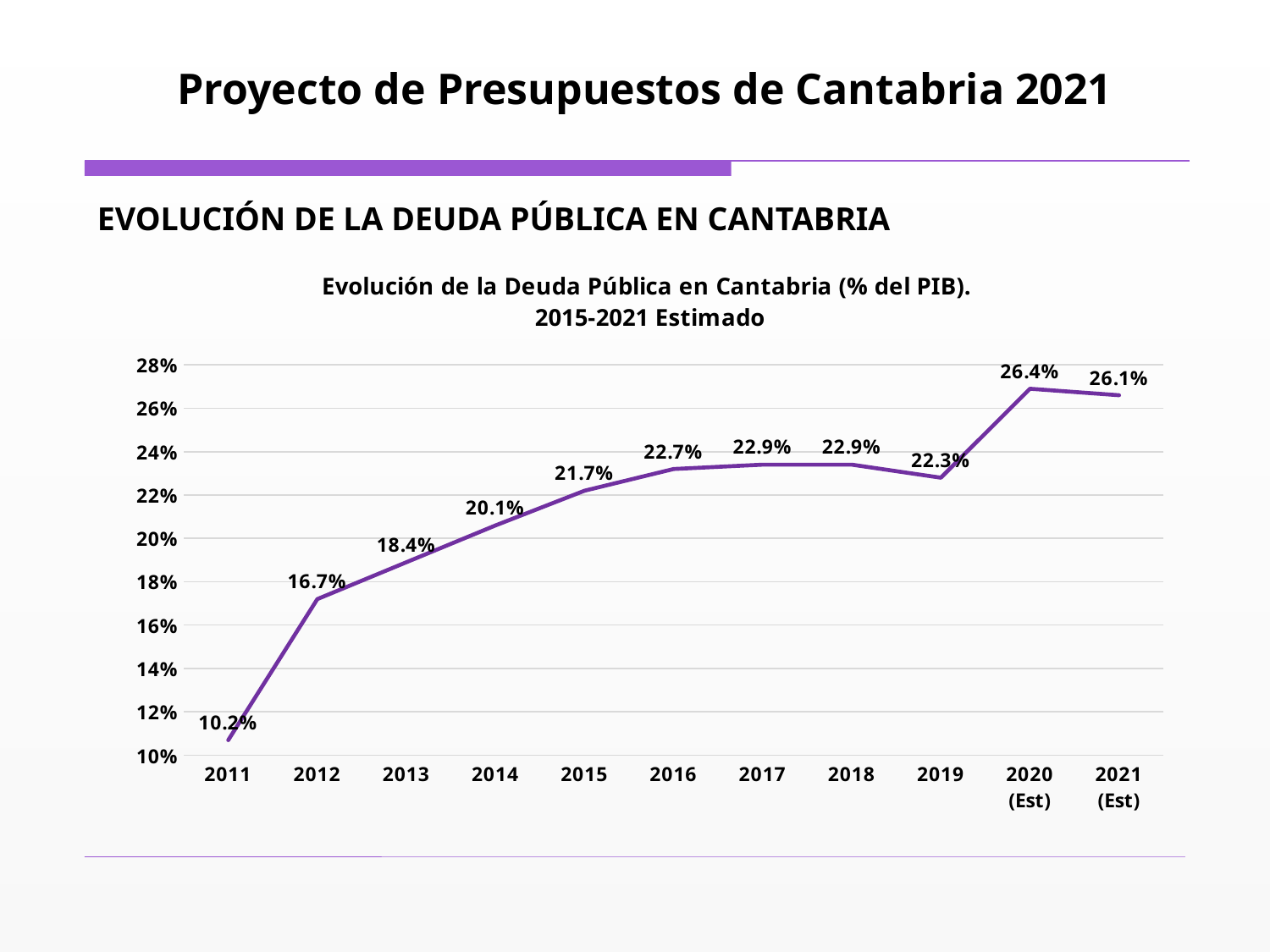
What is the value shown for 2011? 10.2% Which year has the lowest value on the chart? 2011 What is the difference between the values for 2020 (Est) and 2019? 4.1% What is the title of the chart? Evolución de la Deuda Pública en Cantabria (% del PIB). 2015-2021 Estimado What kind of chart is shown on the slide? line chart What is the difference between the values for 2012 and 2011? 6.5% What is the estimated value for 2021 (Est)? 26.1% Which is larger, the value for 2016 or the value for 2019? 2016 Is the value for 2014 greater or less than 22%? less How many years are plotted on the chart? 11 Which year has the highest value on the chart? 2020 (Est) What is the public debt value for 2015? 21.7%